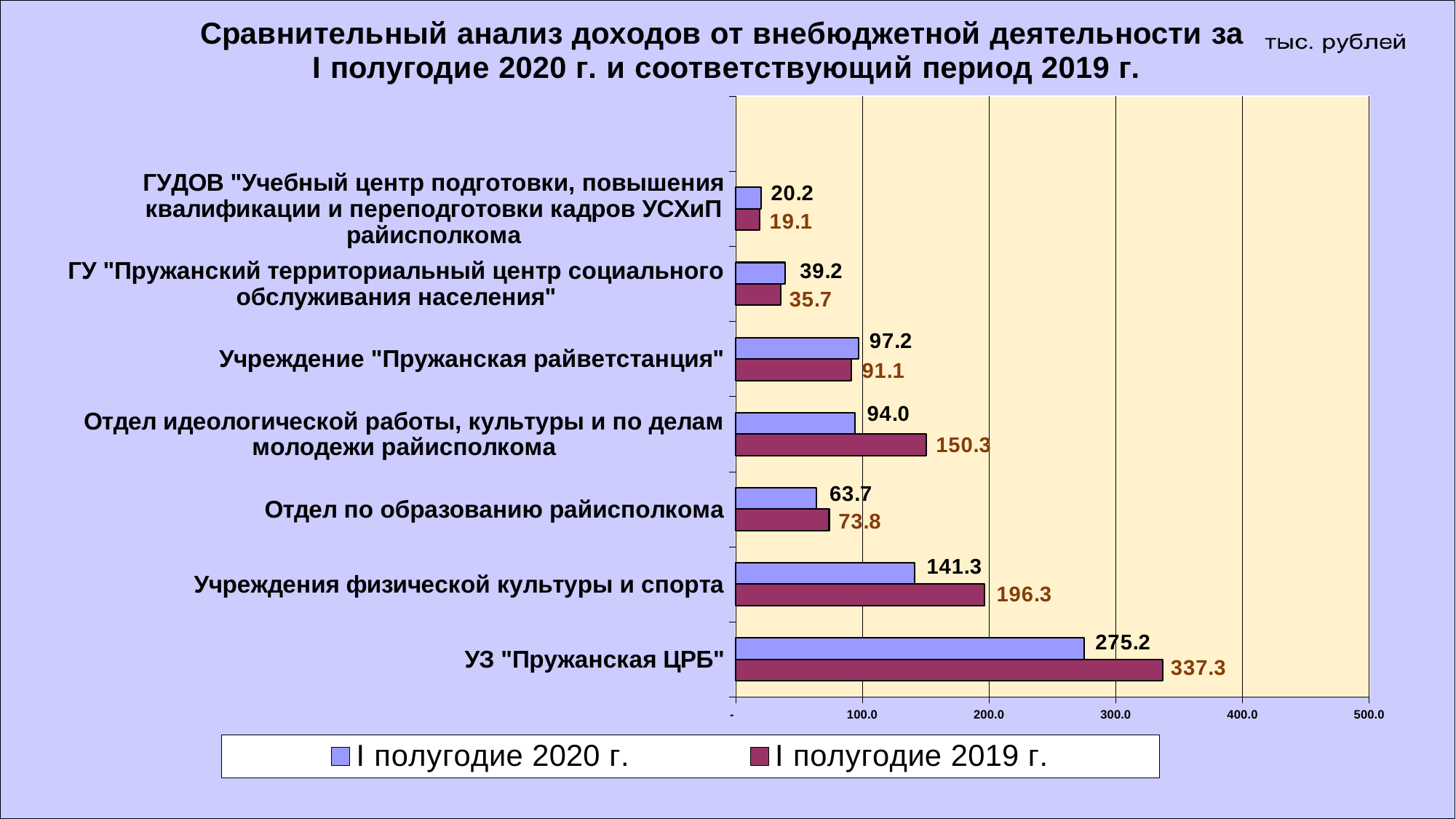
What is the value for Отдел по образованию райисполкома in the I полугодие 2020 г. series? 63.7 How many categories are shown on the chart? 7 Which category has the highest value in the I полугодие 2019 г. series? УЗ "Пружанская ЦРБ" Is the I полугодие 2019 г. value for Учреждения физической культуры и спорта greater or less than 200.0? less What kind of chart is shown on the slide? bar chart What is the value for УЗ "Пружанская ЦРБ" in the I полугодие 2020 г. series? 275.2 What is the difference between the I полугодие 2019 г. and I полугодие 2020 г. values for УЗ "Пружанская ЦРБ"? 62.1 For Отдел идеологической работы, культуры и по делам молодежи райисполкома, which series has the larger value: I полугодие 2020 г. or I полугодие 2019 г.? I полугодие 2019 г. What unit is indicated in the top right corner of the chart? тыс. рублей Which category has the lowest value in the I полугодие 2020 г. series? ГУДОВ "Учебный центр подготовки, повышения квалификации и переподготовки кадров УСХиП райисполкома" What is the value for Учреждения физической культуры и спорта in the I полугодие 2019 г. series? 196.3 How many series does the legend list? 2